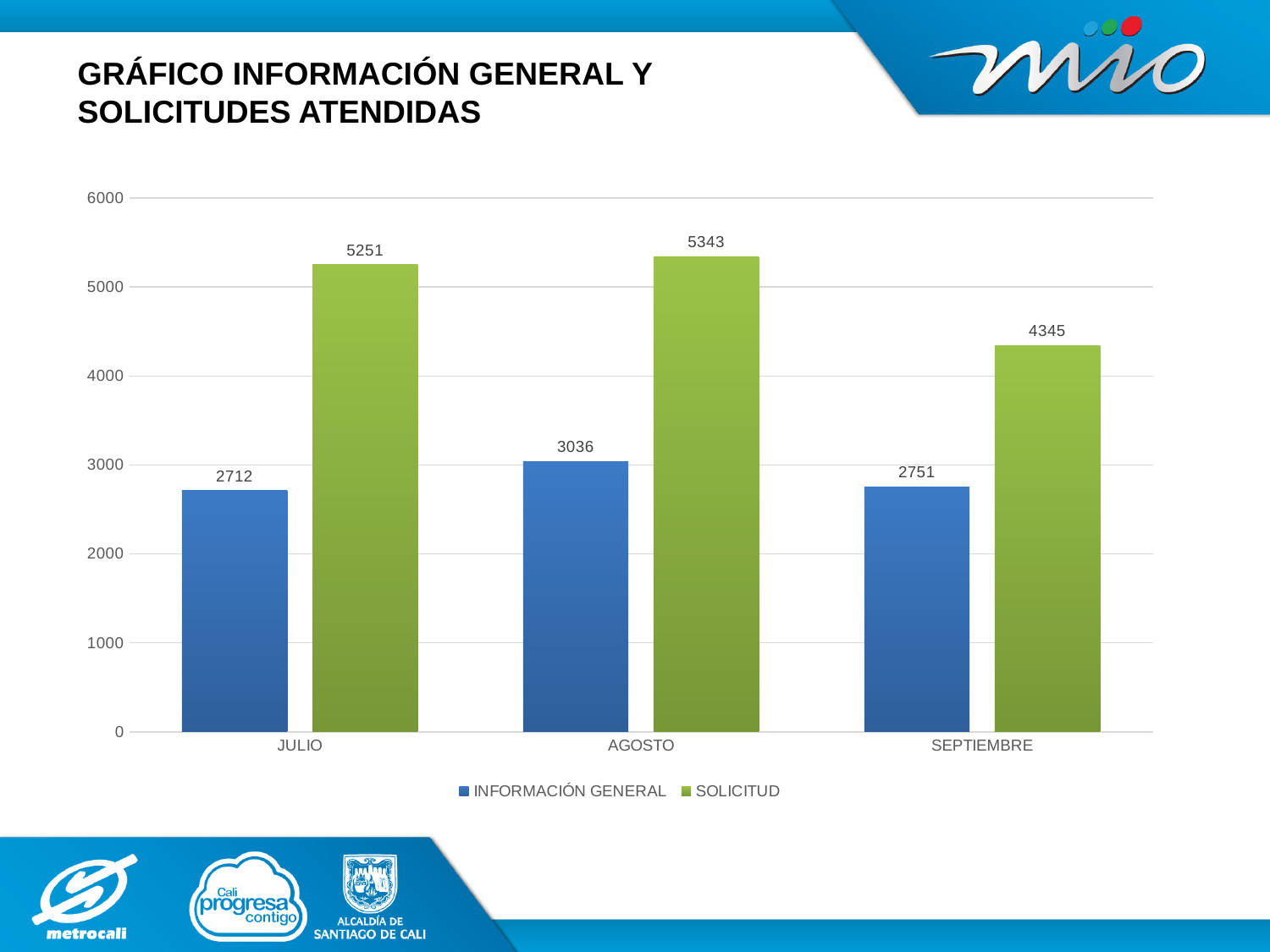
How many months are shown on the x axis? 3 What is the value of SOLICITUD for SEPTIEMBRE? 4345 Which colour represents the SOLICITUD series? green How many series does the legend list? 2 What is the difference between SOLICITUD and INFORMACIÓN GENERAL in JULIO? 2539 What kind of chart is shown on the slide? bar chart What is the value of SOLICITUD for AGOSTO? 5343 Which month has the lowest INFORMACIÓN GENERAL value? JULIO Which month has the highest SOLICITUD value? AGOSTO Which is larger: INFORMACIÓN GENERAL in AGOSTO or INFORMACIÓN GENERAL in SEPTIEMBRE? AGOSTO What is the value of INFORMACIÓN GENERAL for JULIO? 2712 Is the SOLICITUD value for SEPTIEMBRE greater or less than 5000? less